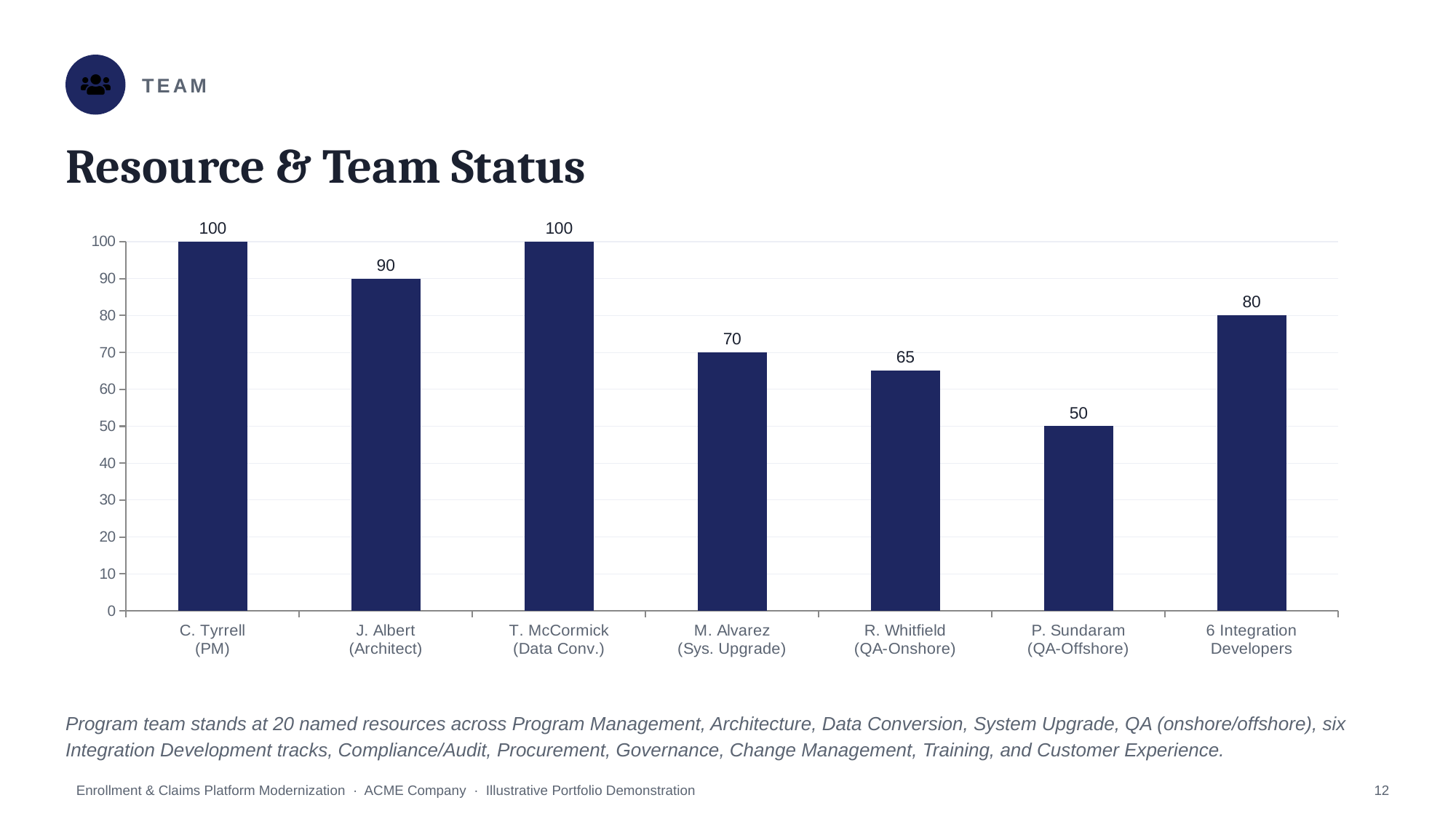
What is the difference between the values for J. Albert (Architect) and R. Whitfield (QA-Onshore)? 25 What is the value for M. Alvarez (Sys. Upgrade)? 70 Which category has the lowest value? P. Sundaram (QA-Offshore) What is the title of the slide containing the chart? Resource & Team Status What is the difference between the values for C. Tyrrell (PM) and P. Sundaram (QA-Offshore)? 50 Is the value for R. Whitfield (QA-Onshore) greater or less than 60? greater What is the value for J. Albert (Architect)? 90 What is the value for 6 Integration Developers? 80 Which is larger, the value for M. Alvarez (Sys. Upgrade) or the value for 6 Integration Developers? 6 Integration Developers What is the value for R. Whitfield (QA-Onshore)? 65 What kind of chart is shown on the slide? Bar chart How many categories are shown on the x axis? 7